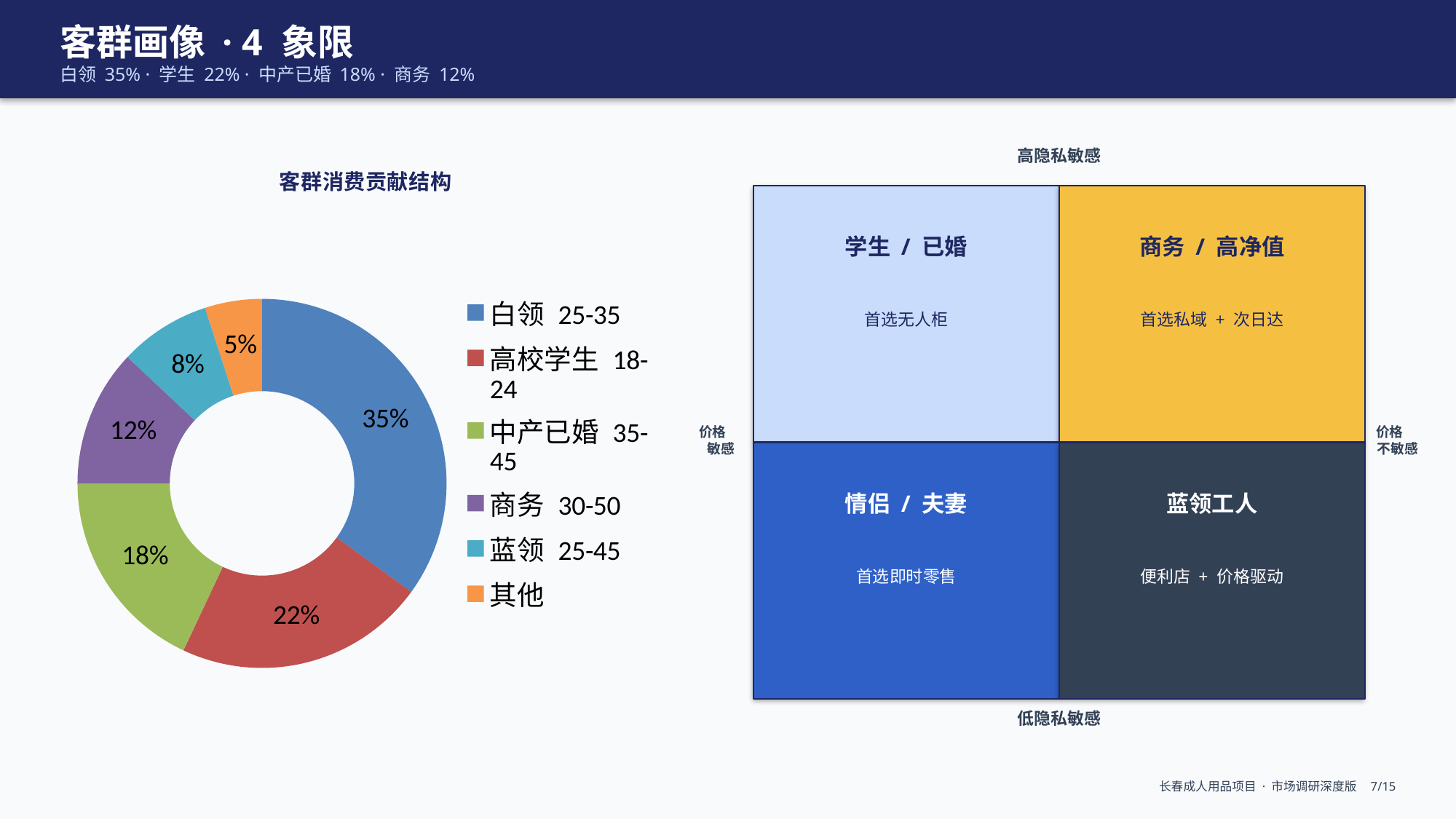
In the "客群消费贡献结构" chart, which is larger: 高校学生 18-24 or 中产已婚 35-45? 高校学生 18-24 In the "客群消费贡献结构" chart, what is the value for 其他? 5% What is the title of the doughnut chart on the left of the slide? 客群消费贡献结构 In the "客群消费贡献结构" chart, what is the value for 白领 25-35? 35% Which category has the smallest share in the "客群消费贡献结构" chart? 其他 What type of chart is "客群消费贡献结构"? Doughnut chart In the "客群消费贡献结构" chart, what is the difference between the shares of 中产已婚 35-45 and 商务 30-50? 6% Which category has the largest share in the "客群消费贡献结构" chart? 白领 25-35 How many categories does the "客群消费贡献结构" chart show? 6 In the "客群消费贡献结构" chart, what is the value for 高校学生 18-24? 22% In the "客群消费贡献结构" chart, what is the value for 蓝领 25-45? 8% In the "客群消费贡献结构" chart, what colour is the 商务 30-50 slice? Purple